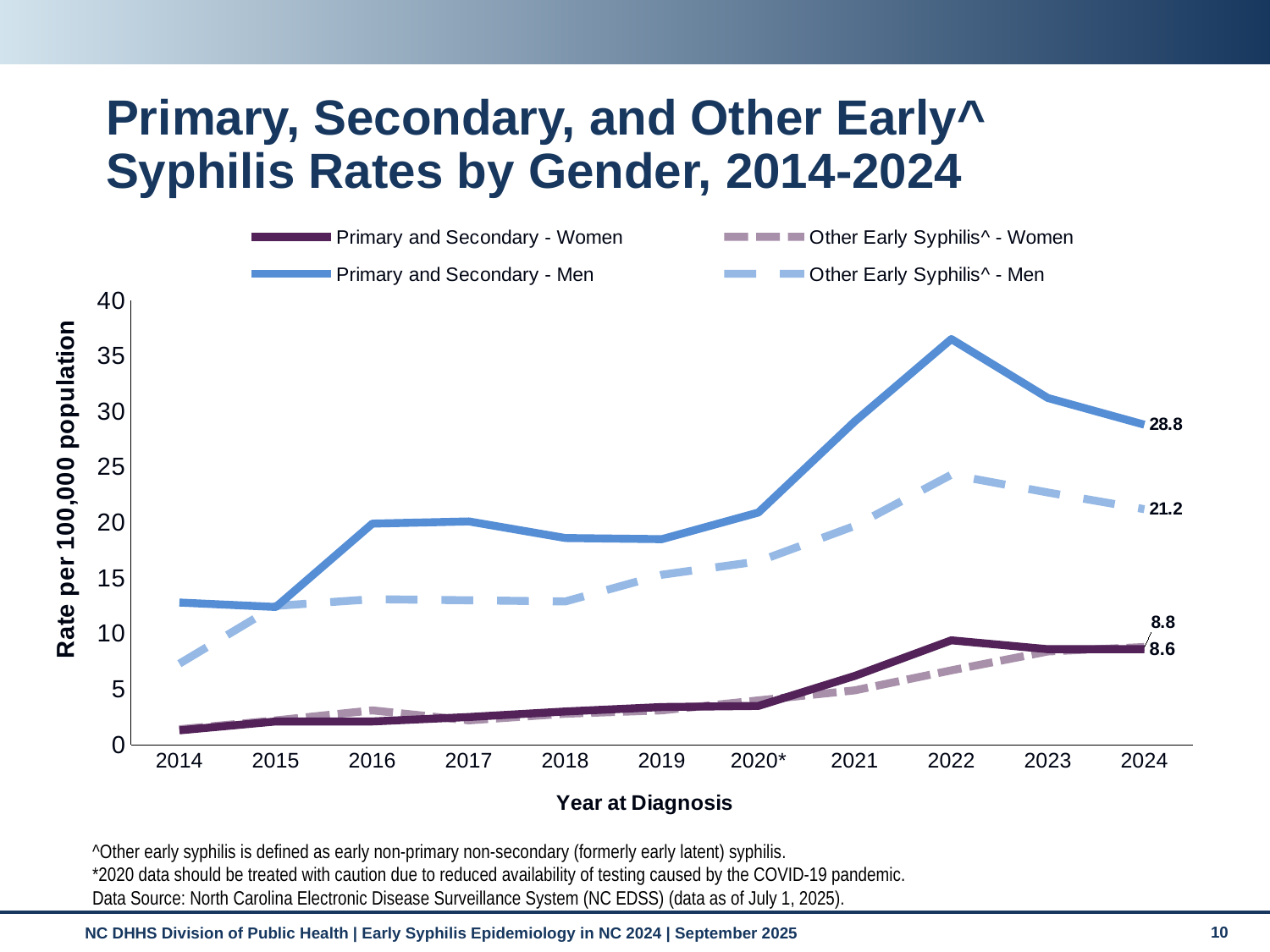
In which year does the Primary and Secondary - Men series reach its highest value? 2022 What type of chart is shown on the slide? line chart How many series does the legend list? 4 Does the Primary and Secondary - Men series rise or fall from 2022 to 2024? fall Is the Primary and Secondary - Men value in 2014 greater or less than 15? less Is the Other Early Syphilis - Men value in 2022 greater or less than 20? greater What is the Primary and Secondary - Men rate in 2024? 28.8 Is the Primary and Secondary - Men value in 2022 greater or less than 35? greater In 2024, which is higher: Primary and Secondary - Men or Other Early Syphilis - Men? Primary and Secondary - Men How many years are shown on the x axis? 11 What is the Other Early Syphilis - Men rate in 2024? 21.2 What is the difference between the Primary and Secondary - Men rate and the Other Early Syphilis - Men rate in 2024? 7.6